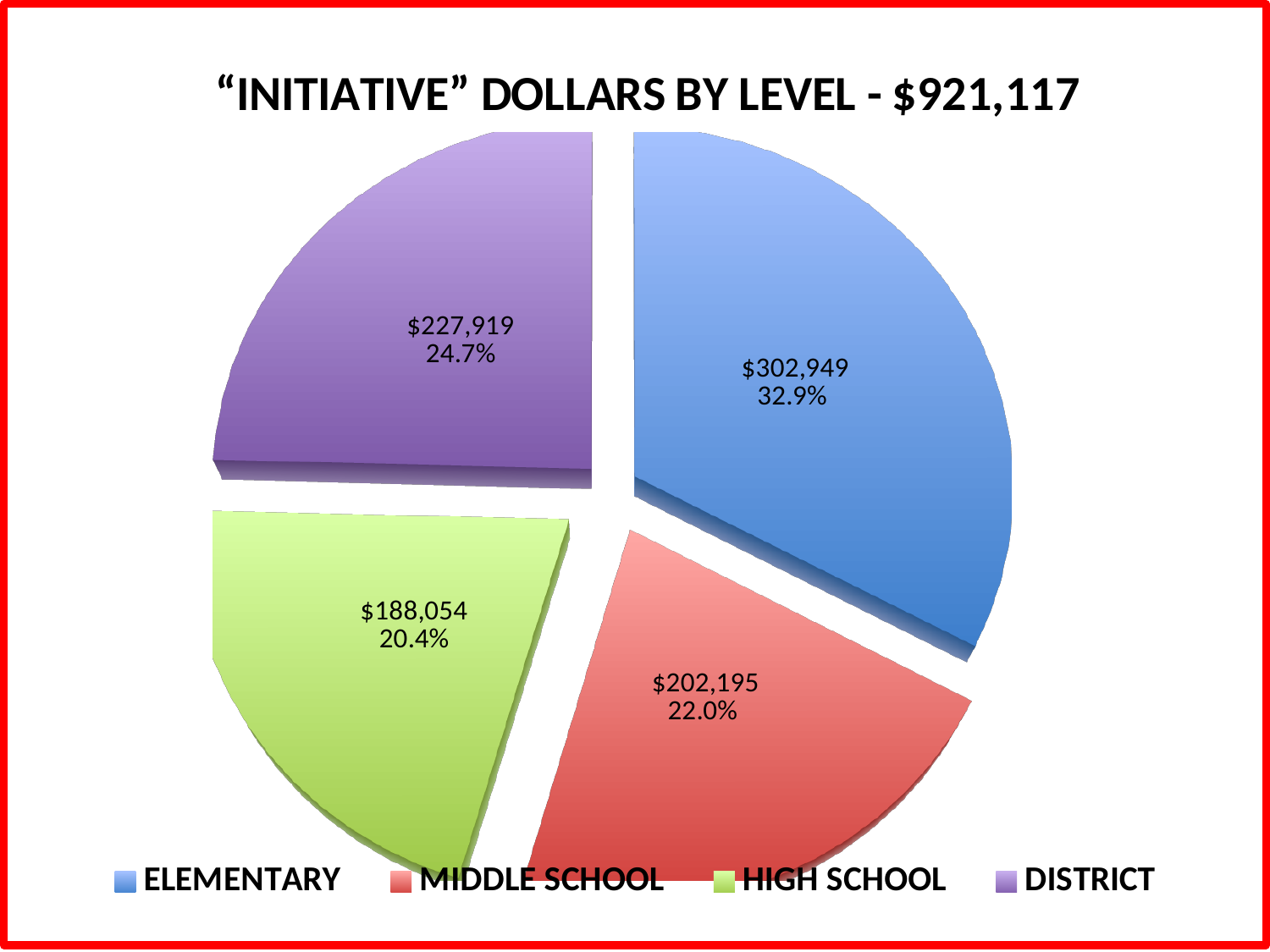
What is the difference in dollars between ELEMENTARY and MIDDLE SCHOOL? $100,754 Which level has the smallest share of initiative dollars? HIGH SCHOOL What is the dollar value for HIGH SCHOOL? $188,054 Which level has the largest share of initiative dollars? ELEMENTARY Which is larger, the value for DISTRICT or the value for MIDDLE SCHOOL? DISTRICT What share of the pie does HIGH SCHOOL represent? 20.4% What is the dollar value for MIDDLE SCHOOL? $202,195 What kind of chart is shown on the slide? pie chart What share of the pie does DISTRICT represent? 24.7% What is the dollar value for ELEMENTARY? $302,949 How many slices does the pie chart have? 4 What is the dollar value for DISTRICT? $227,919